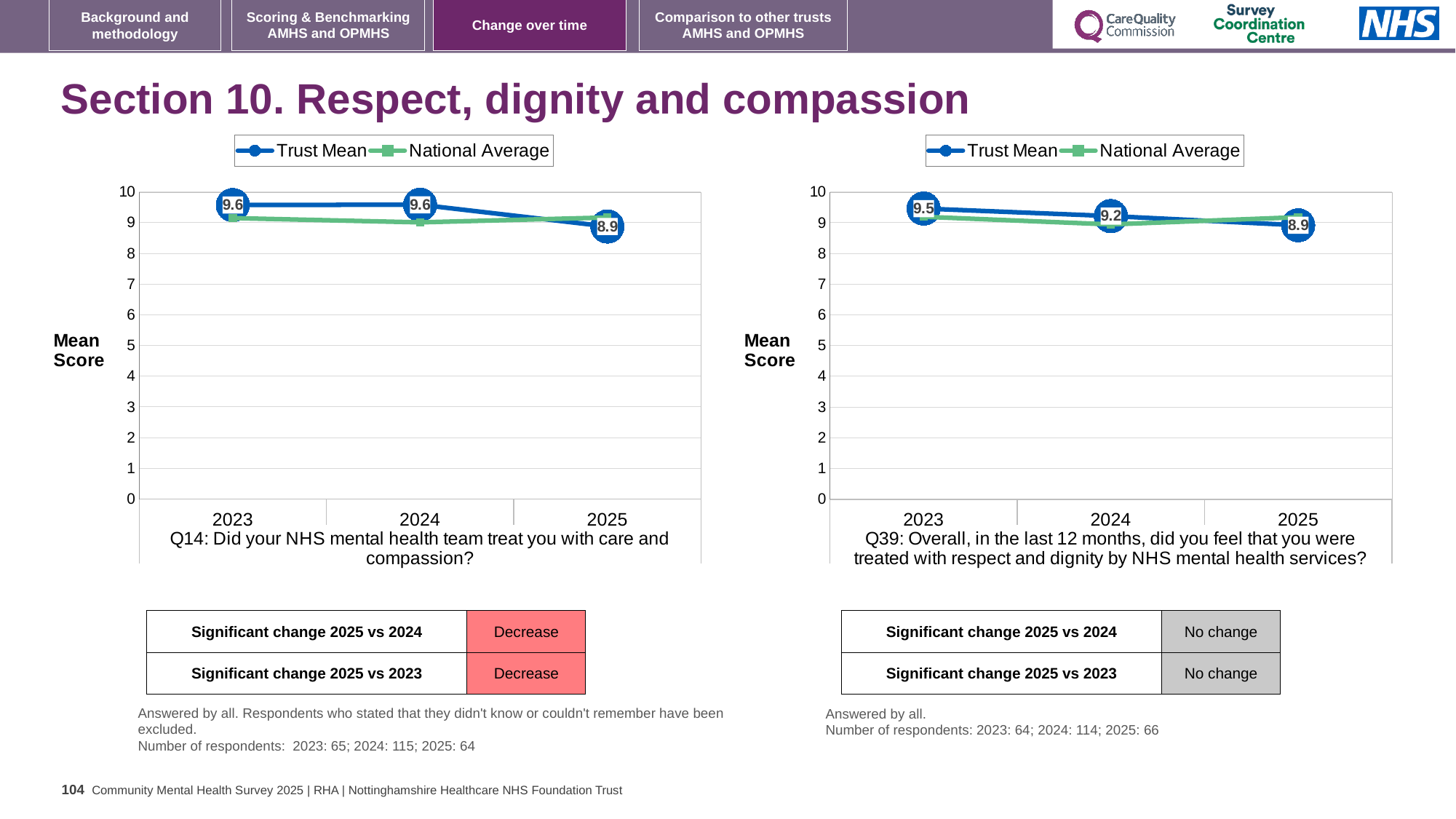
In the Q14 chart on the left, by how much did the Trust Mean fall from 2024 to 2025? 0.7 In the Q14 chart on the left, is the Trust Mean for 2023 larger or smaller than the Trust Mean for 2025? larger How many series does the legend of the Q14 chart on the left list? 2 In the Q39 chart on the right, what is the Trust Mean for 2024? 9.2 In the Q14 chart on the left, what is the Trust Mean for 2023? 9.6 In the Q39 chart on the right, what is the difference between the Trust Mean in 2023 and in 2025? 0.6 In the Q39 chart on the right, which year has the highest Trust Mean? 2023 What kind of chart is the Q39 chart on the right? line chart In the Q39 chart on the right, which year has the lowest Trust Mean? 2025 In the Q14 chart on the left, what is the Trust Mean for 2025? 8.9 In the Q39 chart on the right, what is the Trust Mean for 2023? 9.5 In the Q14 chart on the left, is the National Average for 2024 greater or less than 8? greater